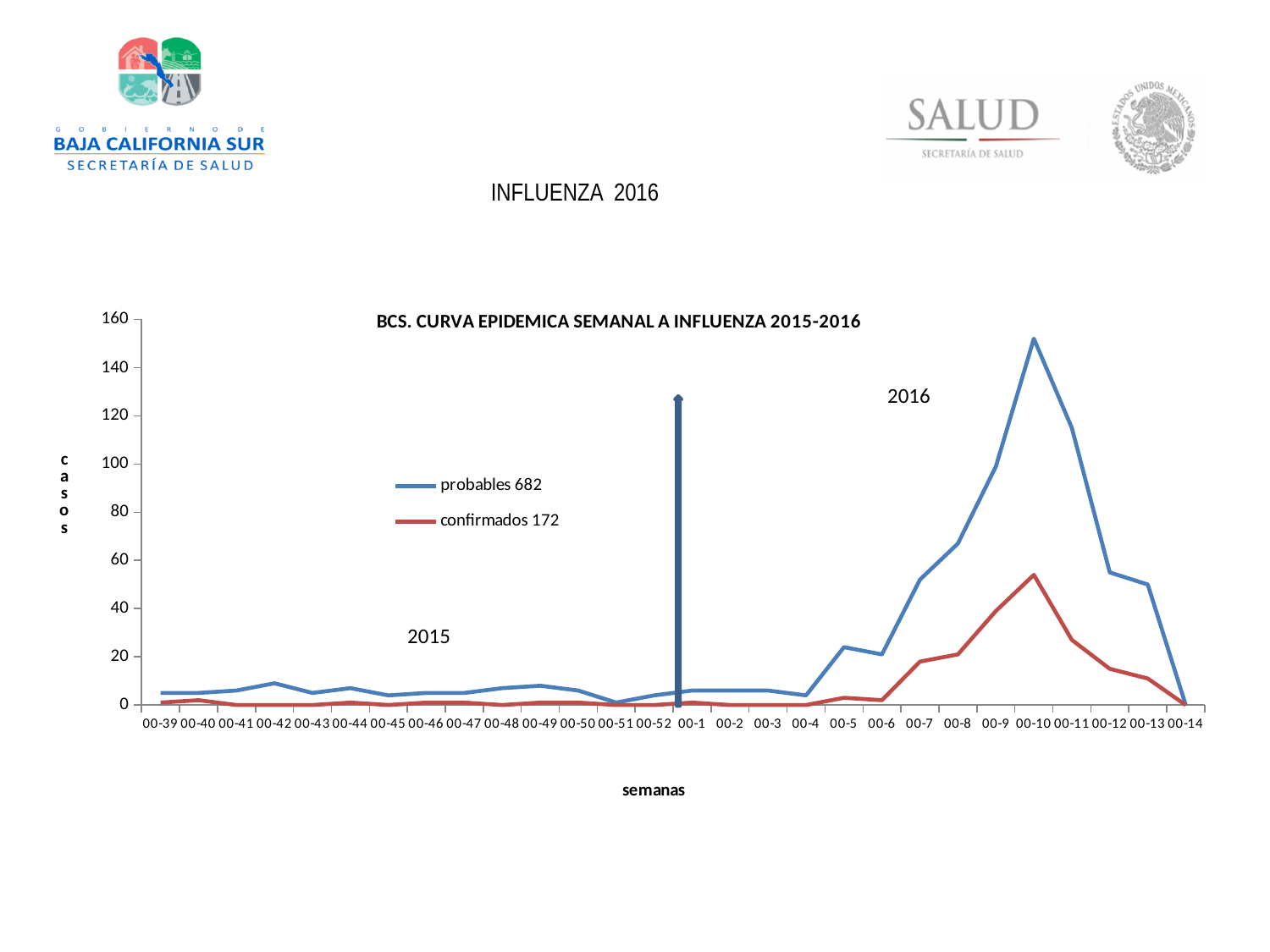
How many weeks are shown on the x axis? 28 Is the value of probables in week 00-14 greater or less than 20? less What is the title of the chart? BCS. CURVA EPIDEMICA SEMANAL A INFLUENZA 2015-2016 Is the value of confirmados in week 00-10 greater or less than 40? greater Do the probables values rise or fall from week 00-10 to week 00-14? fall What are the two legend entries of the chart? probables 682 and confirmados 172 In which week does the probables series reach its highest value? 00-10 How many series does the legend list? 2 What kind of chart is shown on the slide? line chart Which series has the larger value in week 00-9, probables or confirmados? probables In which week does the confirmados series reach its highest value? 00-10 Is the value of probables in week 00-10 greater or less than 140? greater